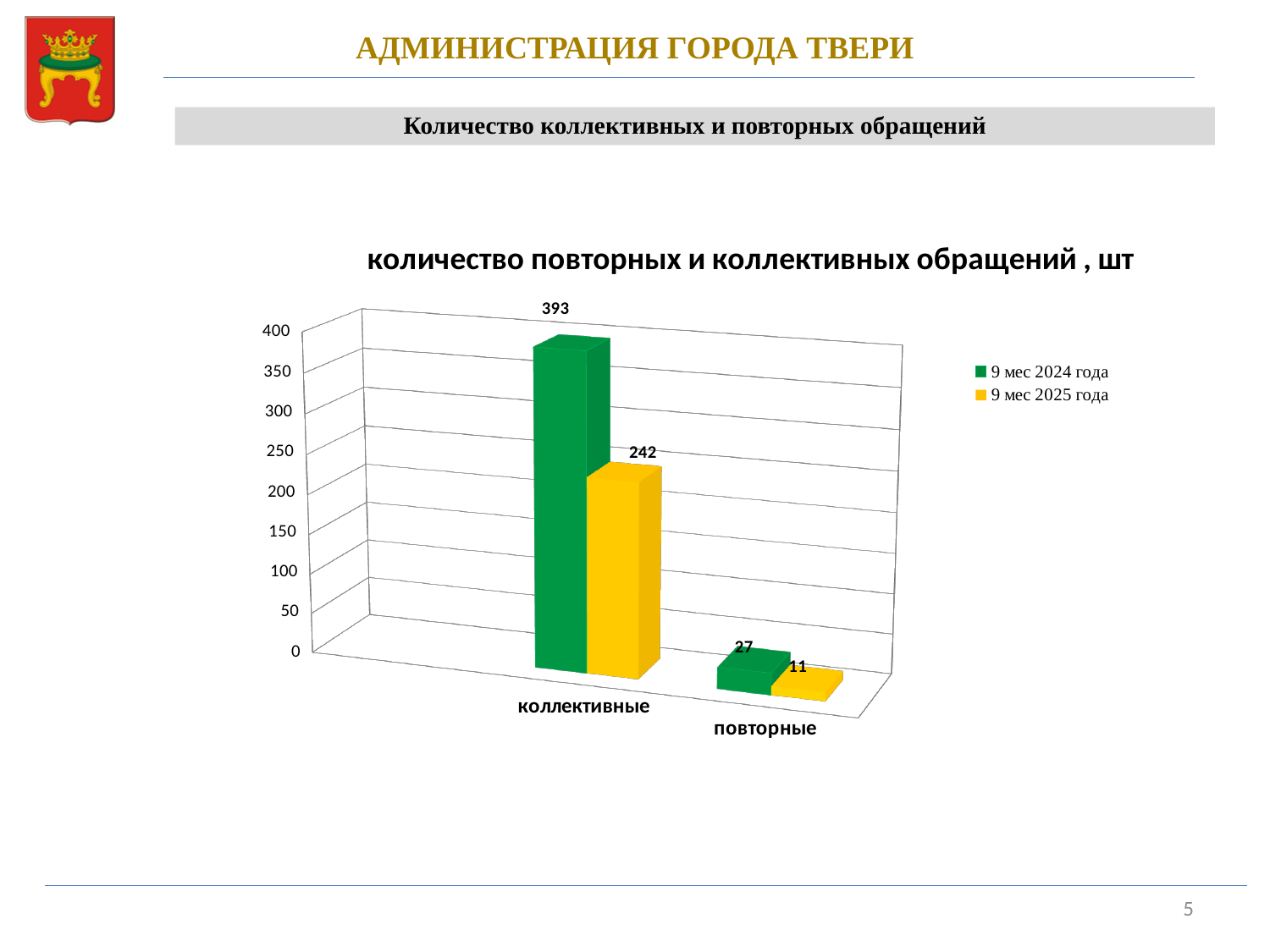
Which is larger for коллективные: the 9 мес 2024 года value or the 9 мес 2025 года value? 9 мес 2024 года What is the value for коллективные in the 9 мес 2025 года series? 242 Which category has the highest value in the 9 мес 2024 года series? коллективные What is the value for коллективные in the 9 мес 2024 года series? 393 What is the difference between the 9 мес 2024 года and 9 мес 2025 года values for коллективные? 151 How many categories are shown on the x axis? 2 What is the value for повторные in the 9 мес 2025 года series? 11 How many series does the legend list? 2 Which category has the lowest value in the 9 мес 2025 года series? повторные What kind of chart is shown on the slide? bar chart What is the value for повторные in the 9 мес 2024 года series? 27 What is the difference between the 9 мес 2024 года and 9 мес 2025 года values for повторные? 16